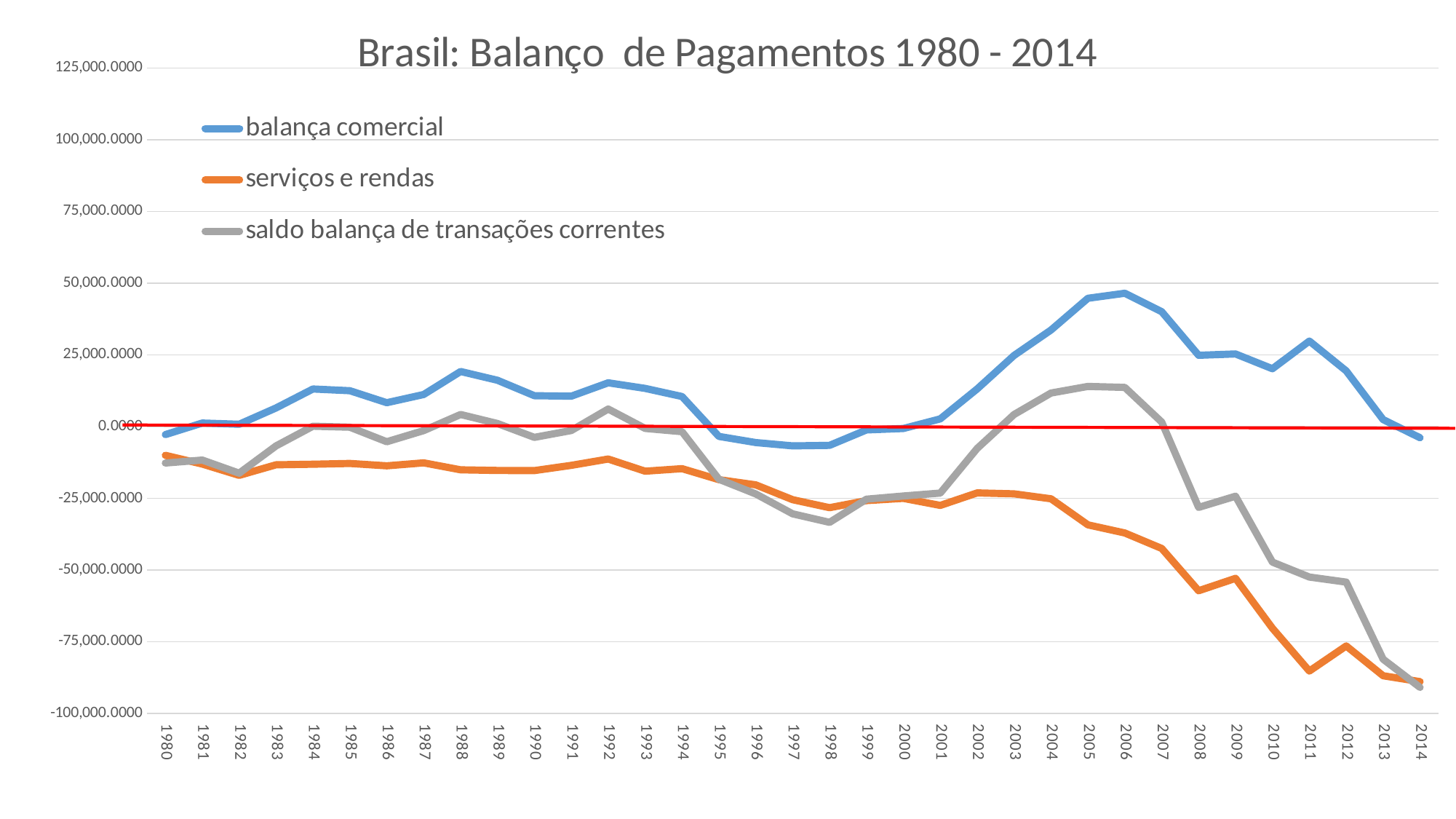
In 2006, which series has the higher value: balança comercial or serviços e rendas? balança comercial What kind of chart is shown on the slide? line chart Is the value for saldo balança de transações correntes in 2005 greater or less than 0.0000? greater Is the value for balança comercial in 2006 greater or less than 25,000.0000? greater What is the title of the chart? Brasil: Balanço de Pagamentos 1980 - 2014 Does the serviços e rendas series rise or fall from 2007 to 2014? fall Which series is drawn in orange? serviços e rendas Is the value for serviços e rendas in 2011 greater or less than -75,000.0000? less In which year is saldo balança de transações correntes at its lowest? 2014 How many years are plotted along the x axis? 35 How many series does the legend list? 3